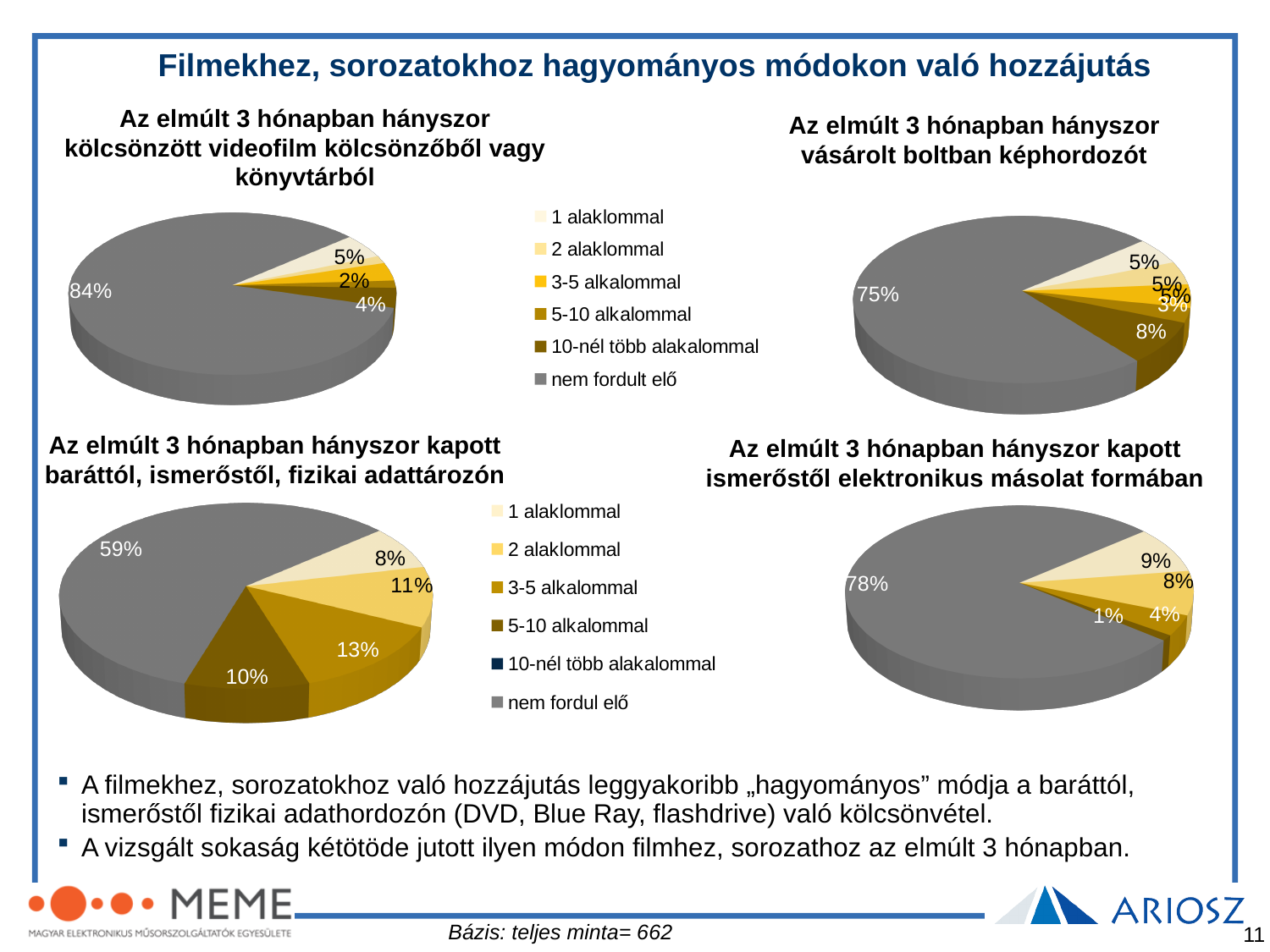
Which of the four charts has the smallest 'nem fordul elő' slice? Az elmúlt 3 hónapban hányszor kapott baráttól, ismerőstől, fizikai adattározón (59%) In the bottom-left chart (fizikai adattározón), what share is labelled for '1 alaklommal'? 8% In the chart 'Az elmúlt 3 hónapban hányszor vásárolt boltban képhordozót', what share is labelled for 'nem fordult elő'? 75% In the chart 'Az elmúlt 3 hónapban hányszor kölcsönzött videofilm kölcsönzőből vagy könyvtárból', what share is labelled for 'nem fordult elő'? 84% How many entries does the legend next to the bottom-left chart list? 6 In the bottom-left chart (fizikai adattározón), which is larger: '3-5 alkalommal' or '5-10 alkalommal'? 3-5 alkalommal In the bottom-left chart (fizikai adattározón), what share is labelled for '3-5 alkalommal'? 13% In the chart 'Az elmúlt 3 hónapban hányszor kapott baráttól, ismerőstől, fizikai adattározón', what share is labelled for 'nem fordul elő'? 59% In the chart 'Az elmúlt 3 hónapban hányszor kapott ismerőstől elektronikus másolat formában', what share is labelled for 'nem fordul elő'? 78% In the bottom-right chart (elektronikus másolat formában), what share is labelled for '1 alaklommal'? 9% What kind of chart is used for the four charts on the slide? Pie chart In the bottom-left chart (fizikai adattározón), what is the difference between the '2 alaklommal' share (11%) and the '1 alaklommal' share (8%)? 3 percentage points